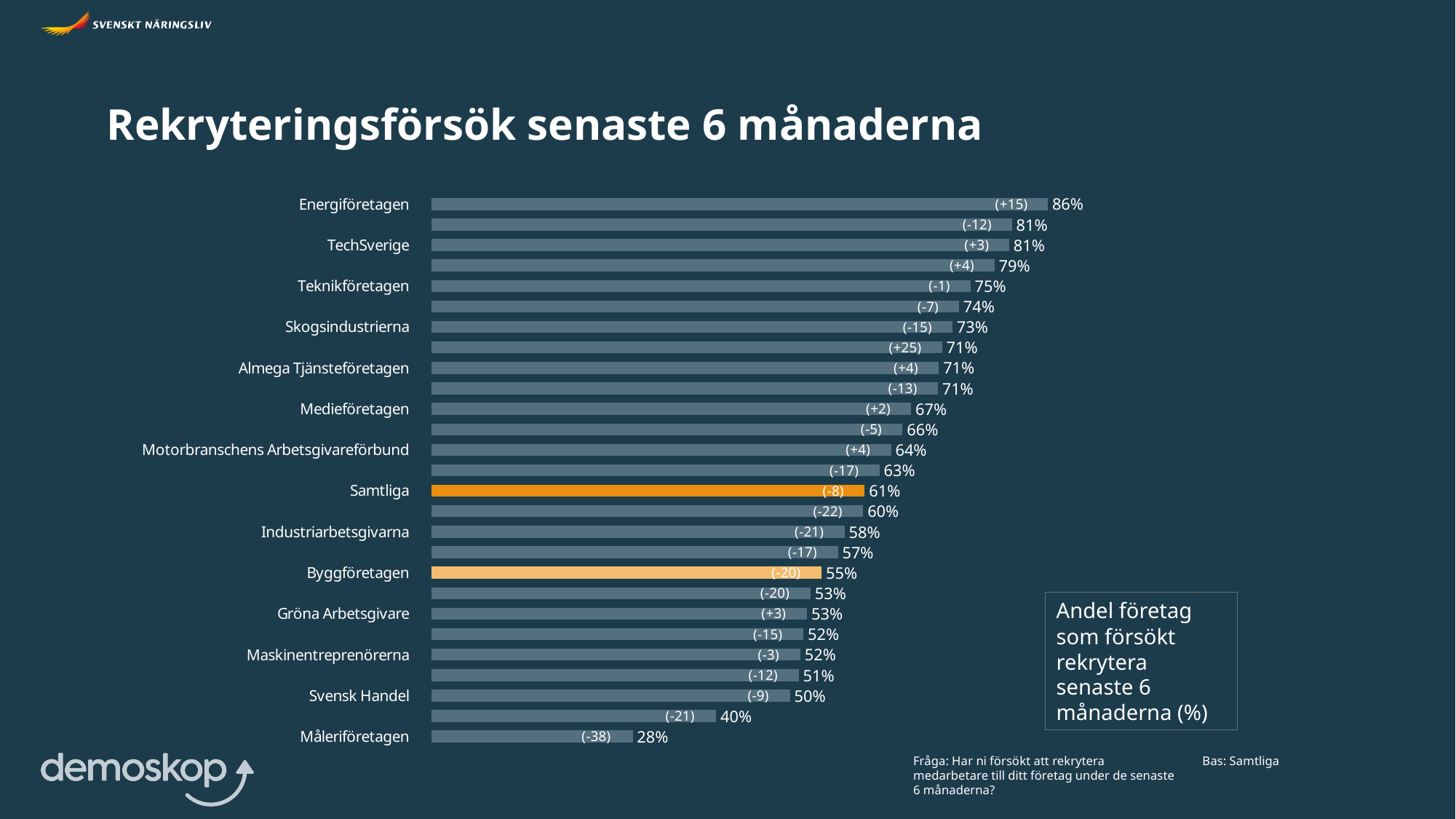
What is the value for Byggföretagen? 55% What colour is the bar for Samtliga? Orange Which labelled category has the lowest value? Måleriföretagen Which labelled category has the highest value? Energiföretagen What kind of chart is shown on the slide? Bar chart What is the value for Måleriföretagen? 28% What is the difference between the values for TechSverige and Svensk Handel? 31 percentage points What is the value for Energiföretagen? 86% Which has a larger value, Skogsindustrierna or Medieföretagen? Skogsindustrierna What is the difference between the values for Energiföretagen and Måleriföretagen? 58 percentage points What is the value for Samtliga? 61% What change is shown in parentheses next to the bar for Måleriföretagen? (-38)